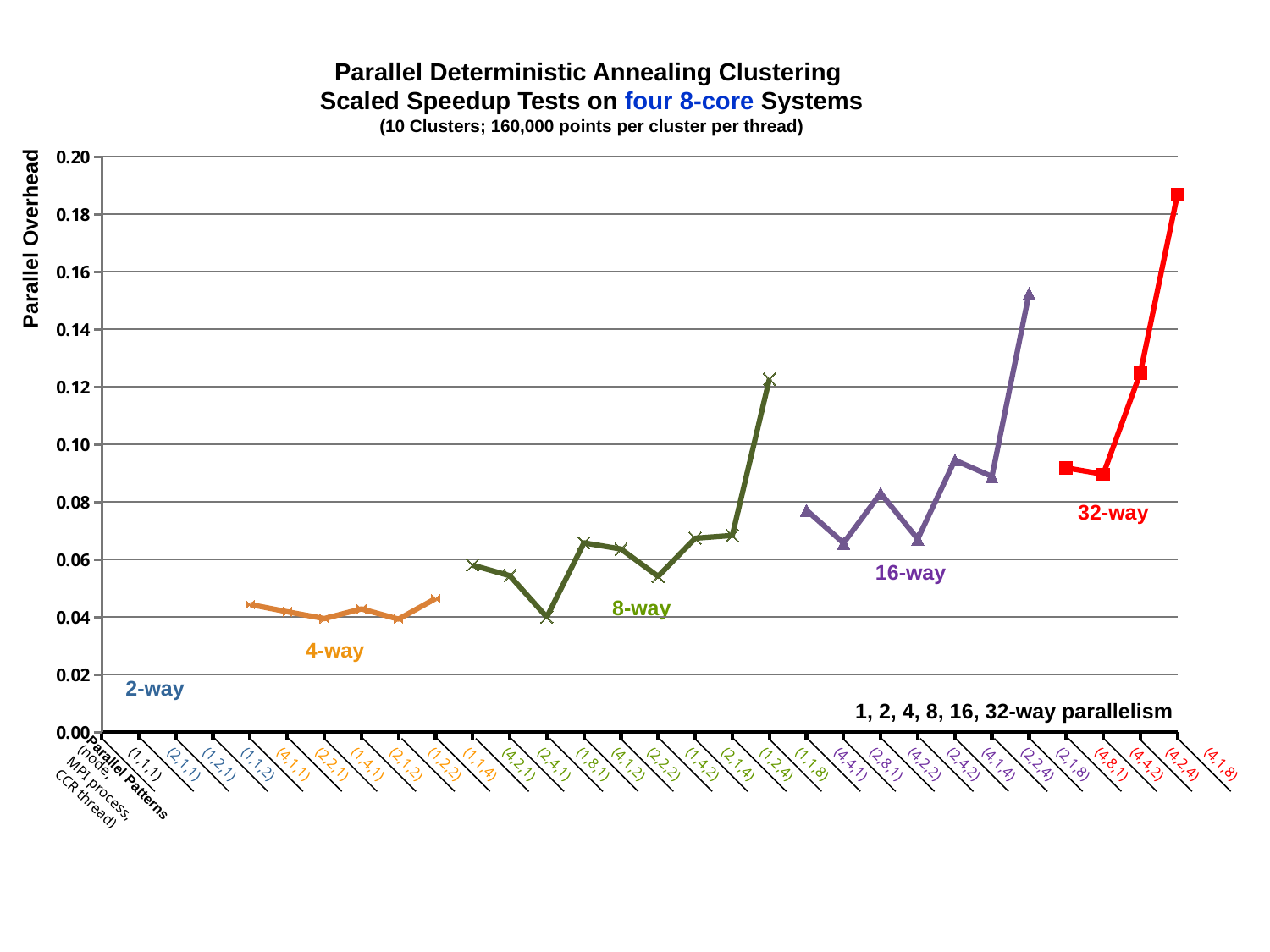
What is the label of the vertical axis? Parallel Overhead Does the Parallel Overhead for the 32-way line rise or fall from (4,4,2) to (4,1,8)? rise Within the 16-way group, which parallel pattern has the highest Parallel Overhead? (2,1,8) Is the Parallel Overhead for pattern (2,4,1) greater or less than 0.06? less Which has the larger Parallel Overhead, pattern (4,1,8) or pattern (2,1,8)? (4,1,8) How many data points are plotted on the 32-way line? 4 Is the Parallel Overhead for pattern (4,1,8) greater or less than 0.18? greater Is the Parallel Overhead for pattern (1,1,8) greater or less than 0.10? greater Which parallel pattern has the highest Parallel Overhead on the chart? (4,1,8) What kind of chart is shown on the slide? line chart